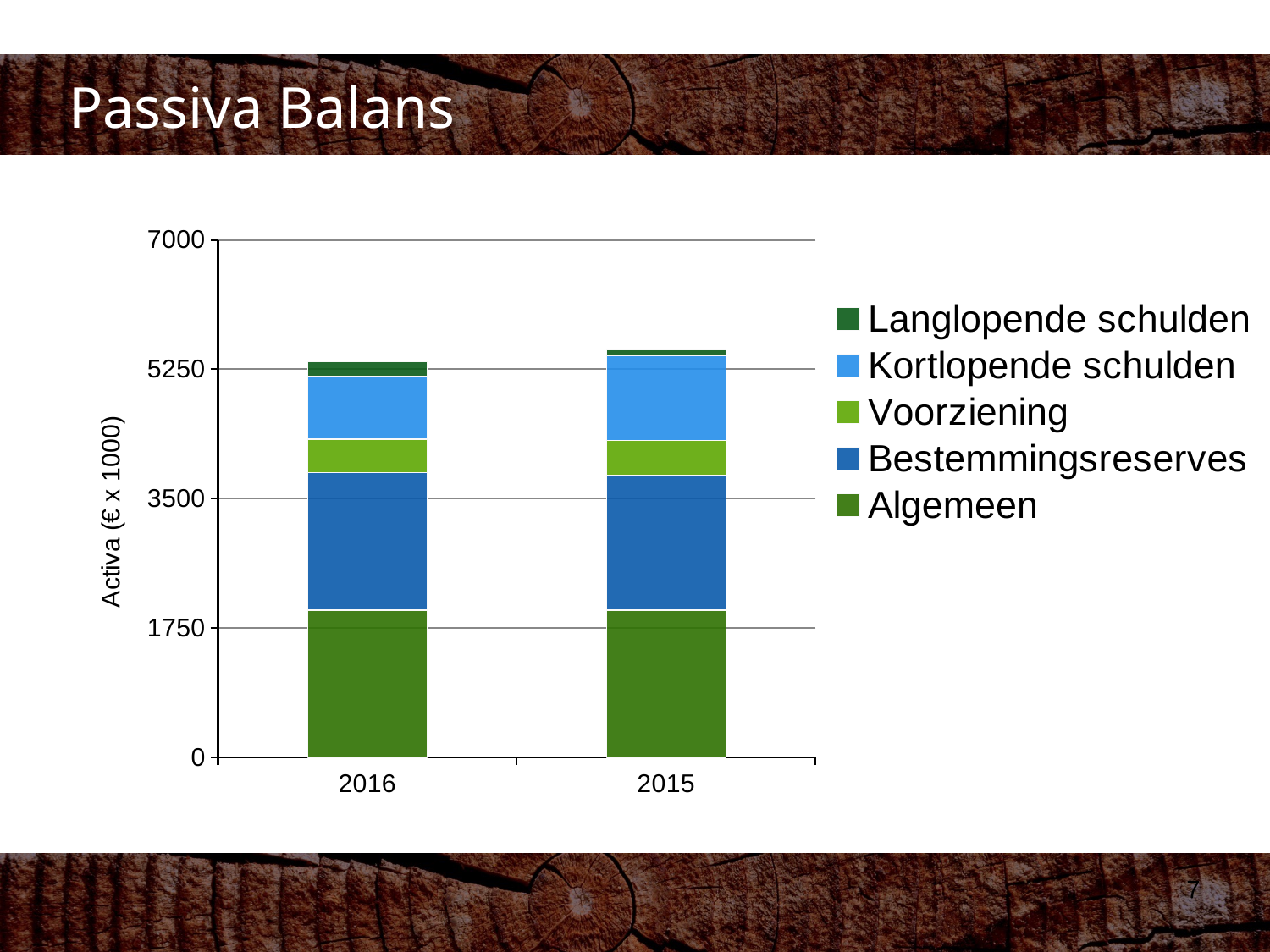
Is the total of the 2015 bar greater or less than 7000? less How many series does the legend list? 5 Which series forms the smallest segment in the 2016 bar? Langlopende schulden What is the title of the slide containing the chart? Passiva Balans What is the label on the vertical axis? Activa (€ x 1000) Is the value for Algemeen in 2016 greater or less than 1750? greater Is the total of the 2015 bar greater or less than 3500? greater What kind of chart is shown on the slide? stacked bar chart Which series forms the smallest segment in the 2015 bar? Langlopende schulden How many years (categories) are shown on the x axis? 2